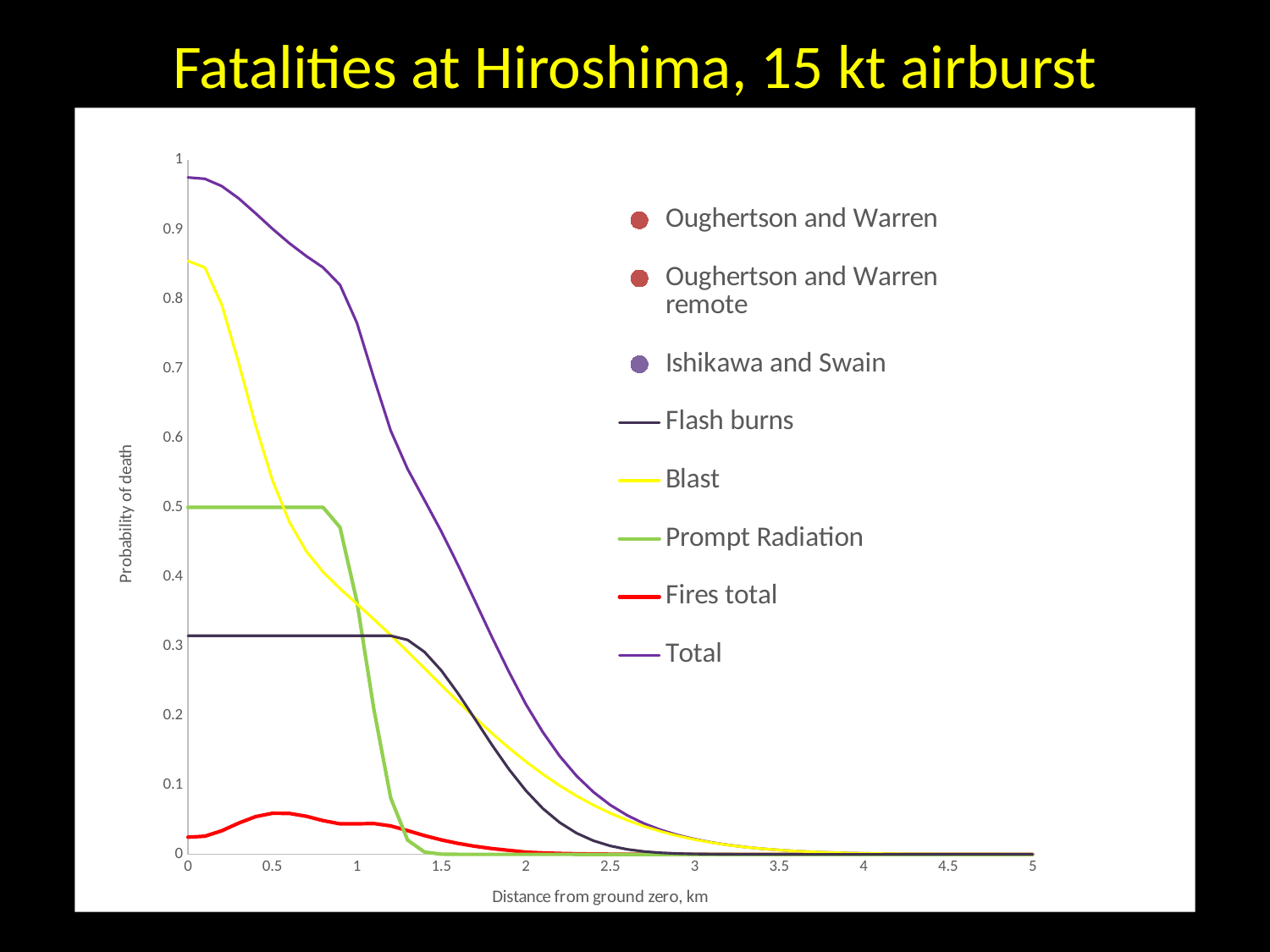
Which plotted series has the lowest value at 0 km? Fires total How many series does the legend list? 8 At 0 km, which series has the higher value, Total or Blast? Total Does the Total probability of death rise or fall as distance from ground zero increases? fall At 1.5 km, which series has the higher value, Total or Prompt Radiation? Total Is the value of the Blast series at 0 km greater or less than 0.8? greater Is the value of the Flash burns series at 0.5 km greater or less than 0.4? less Is the value of the Fires total series at 0.5 km greater or less than 0.1? less What kind of chart is shown on the slide? line chart What is the probability of death for Prompt Radiation at 0.5 km? 0.5 What is the label of the x axis? Distance from ground zero, km